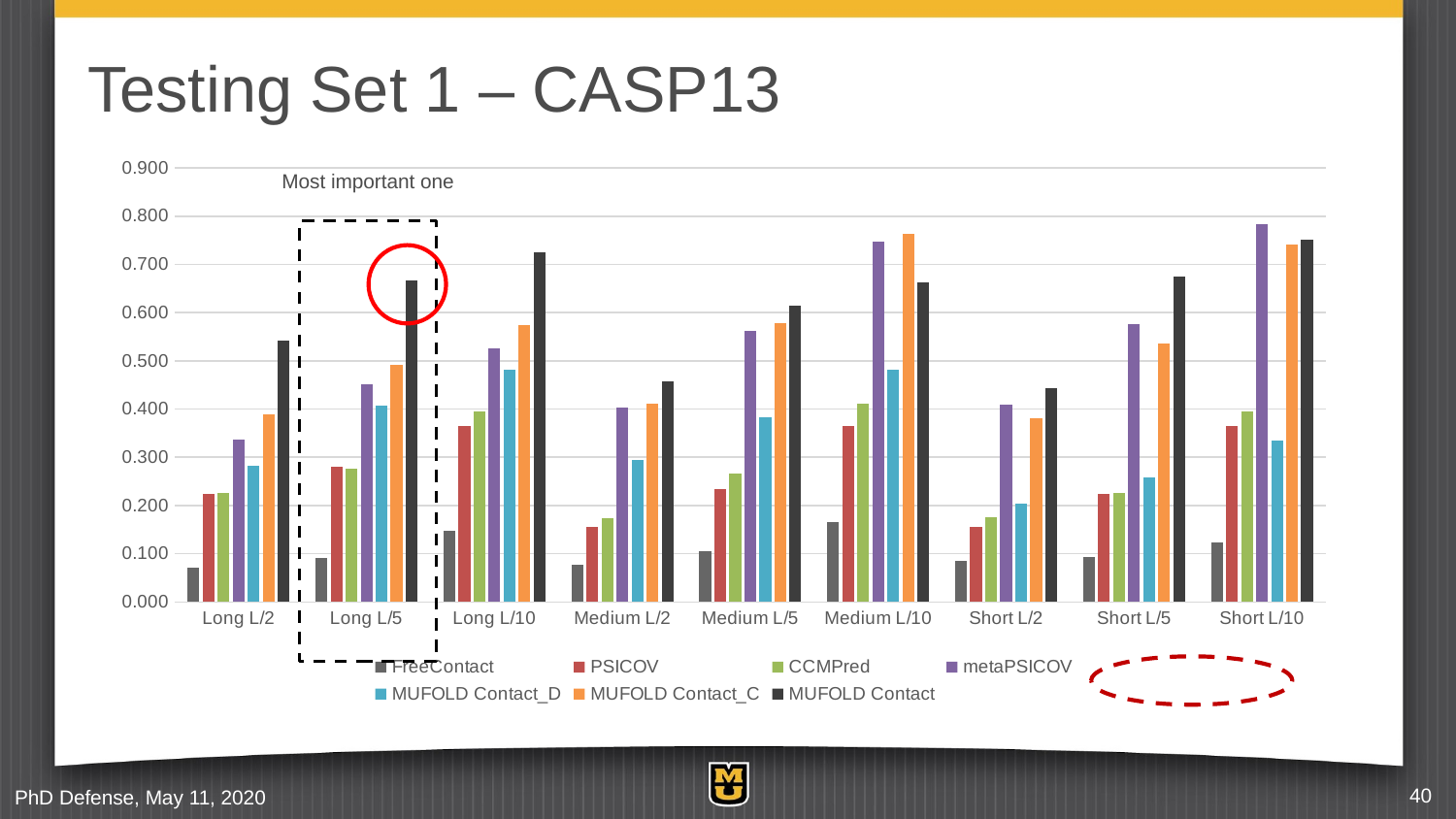
What kind of chart is shown on the slide? bar chart What is the title of the slide containing the chart? Testing Set 1 – CASP13 Is the value for metaPSICOV at Short L/10 greater or less than 0.700? greater How many categories are shown along the x axis of the chart? 9 Is the value for MUFOLD Contact_C at Medium L/10 greater or less than 0.700? greater Is the value for MUFOLD Contact at Long L/5 greater or less than 0.600? greater At Long L/2, which is larger: MUFOLD Contact or MUFOLD Contact_C? MUFOLD Contact How many series does the chart's legend list? 7 At Medium L/10, which is larger: MUFOLD Contact_C or MUFOLD Contact? MUFOLD Contact_C Which series has the lowest value at Long L/2? FreeContact